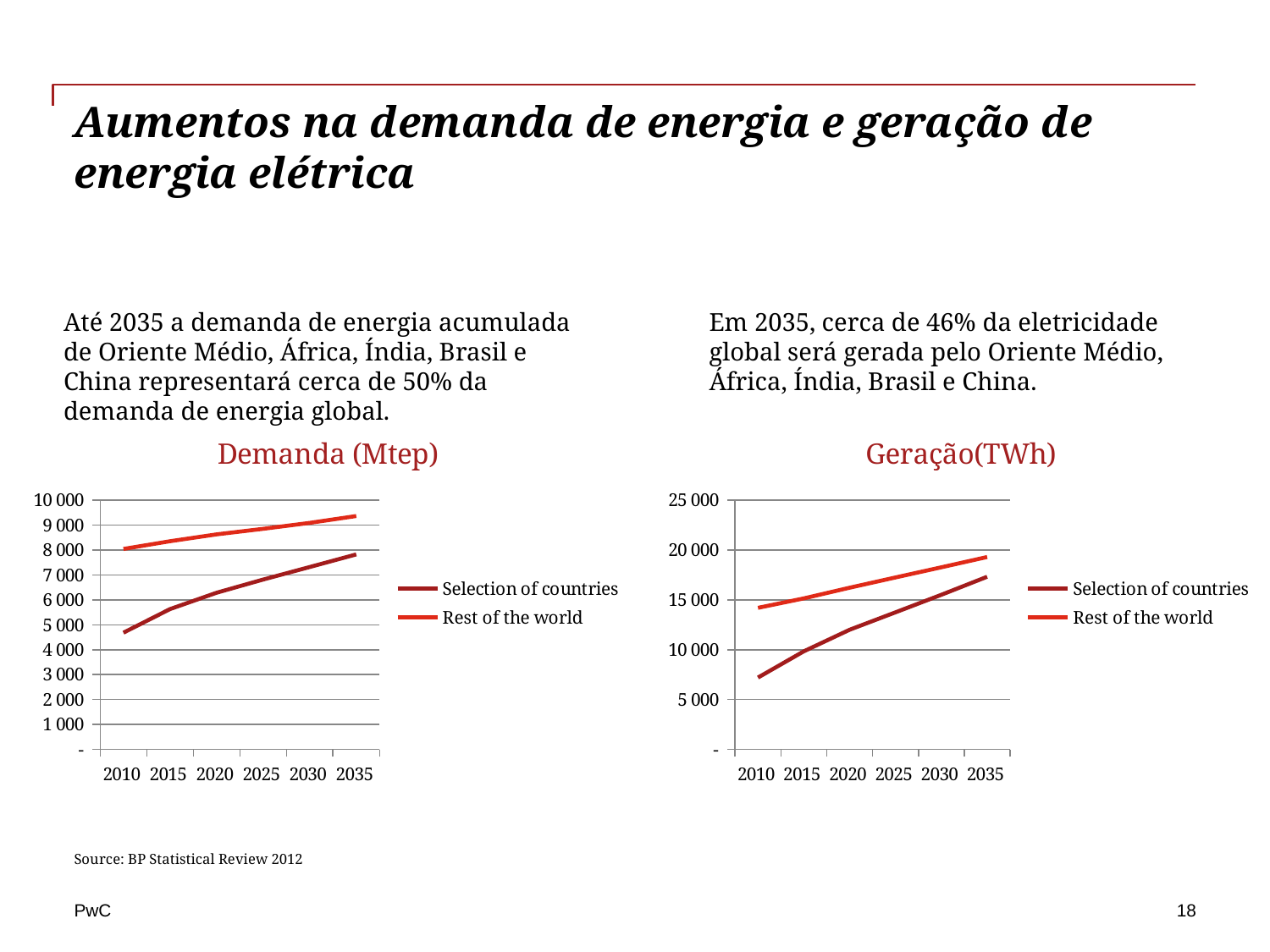
In the Demanda (Mtep) chart, which series has the higher value in 2010, Selection of countries or Rest of the world? Rest of the world In the Demanda (Mtep) chart, does the Selection of countries line rise or fall from 2010 to 2035? rise In the Demanda (Mtep) chart, is the value for Selection of countries in 2010 greater or less than 5 000? less How many series does the legend of the Geração(TWh) chart list? 2 What kind of chart is the Demanda (Mtep) chart? line chart How many years are shown on the x axis of the Demanda (Mtep) chart? 6 In the Geração(TWh) chart, which series has the higher value in 2035, Selection of countries or Rest of the world? Rest of the world What is the title of the chart on the right side of the slide? Geração(TWh) In the Demanda (Mtep) chart, is the value for Rest of the world in 2035 greater or less than 9 000? greater In the Geração(TWh) chart, is the value for Selection of countries in 2010 greater or less than 10 000? less In the Geração(TWh) chart, does the Rest of the world line rise or fall from 2010 to 2035? rise